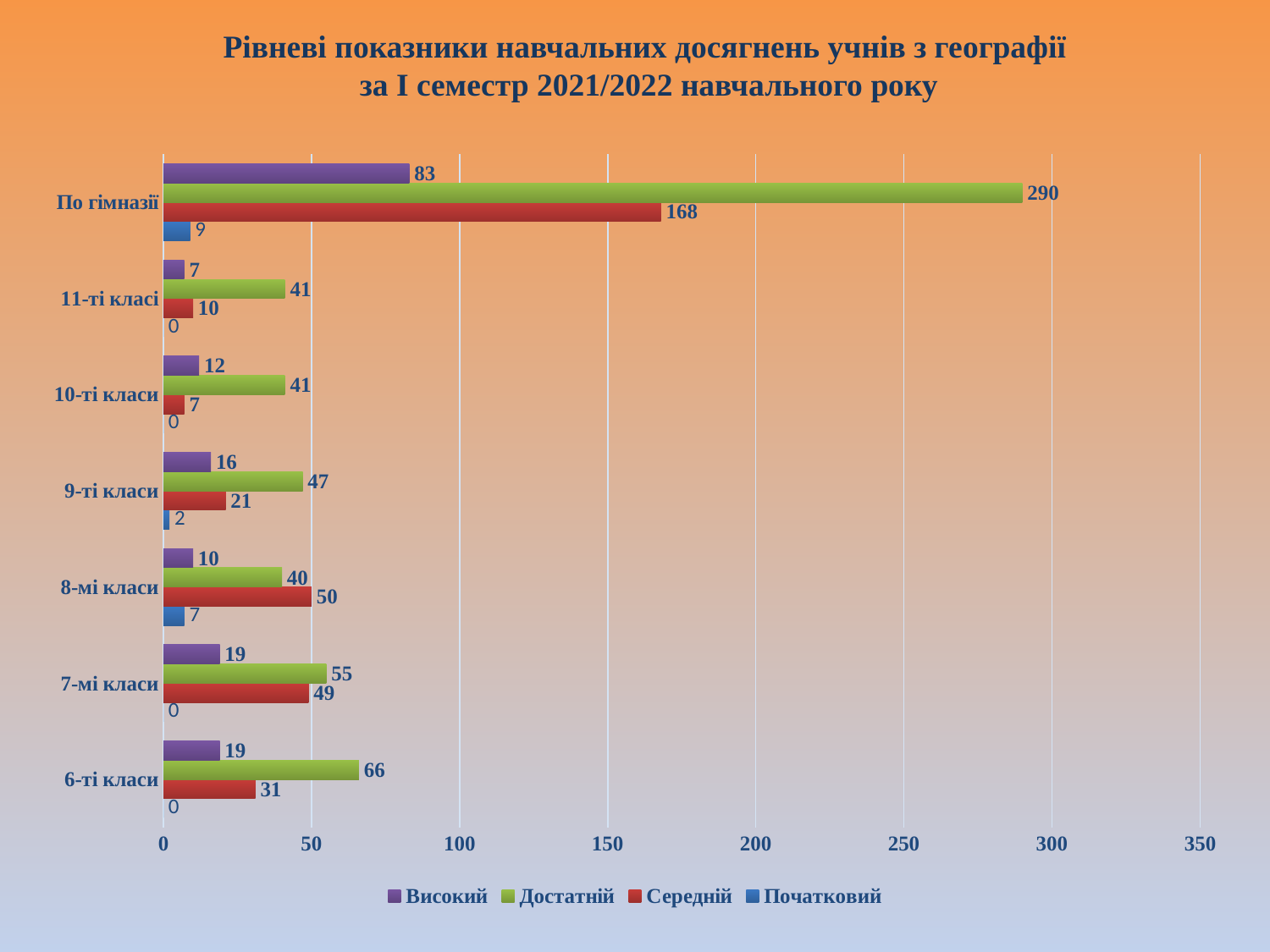
What is the value of Достатній for По гімназії? 290 What is the value of Початковий for 11-ті класі? 0 Which series is shown in green in the legend? Достатній Which is larger for 8-мі класи: Достатній or Середній? Середній What is the difference between the Достатній and Середній values for По гімназії? 122 Among the class categories (excluding По гімназії), which has the lowest Середній value? 10-ті класи How many categories are shown on the vertical axis? 7 What is the value of Середній for 8-мі класи? 50 What type of chart is shown on the slide? bar chart Among the class categories (excluding По гімназії), which has the highest Достатній value? 6-ті класи What is the value of Високий for 9-ті класи? 16 How many series does the legend list? 4